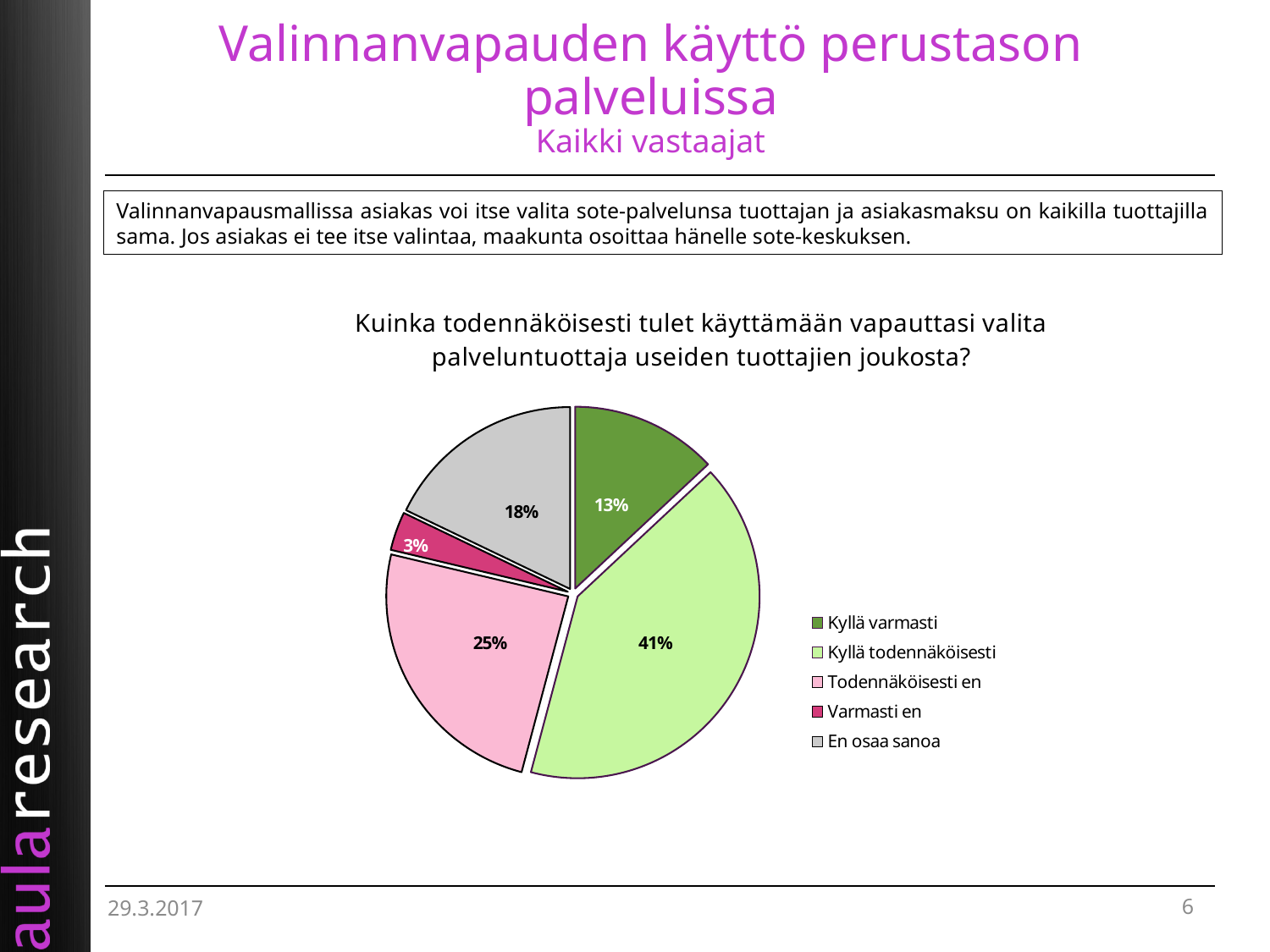
Which response has the largest slice of the pie? Kyllä todennäköisesti What share of respondents answered "En osaa sanoa"? 18% How many categories does the legend list? 5 What share of respondents answered "Todennäköisesti en"? 25% What share of respondents answered "Kyllä varmasti"? 13% What kind of chart is shown on the slide? pie chart Which is larger: the share for "En osaa sanoa" or the share for "Kyllä varmasti"? En osaa sanoa Which response has the smallest slice of the pie? Varmasti en What is the combined share of "Kyllä varmasti" and "Kyllä todennäköisesti"? 54% What share of respondents answered "Varmasti en"? 3% What is the difference in percentage points between "Kyllä todennäköisesti" and "Todennäköisesti en"? 16 What share of respondents answered "Kyllä todennäköisesti"? 41%